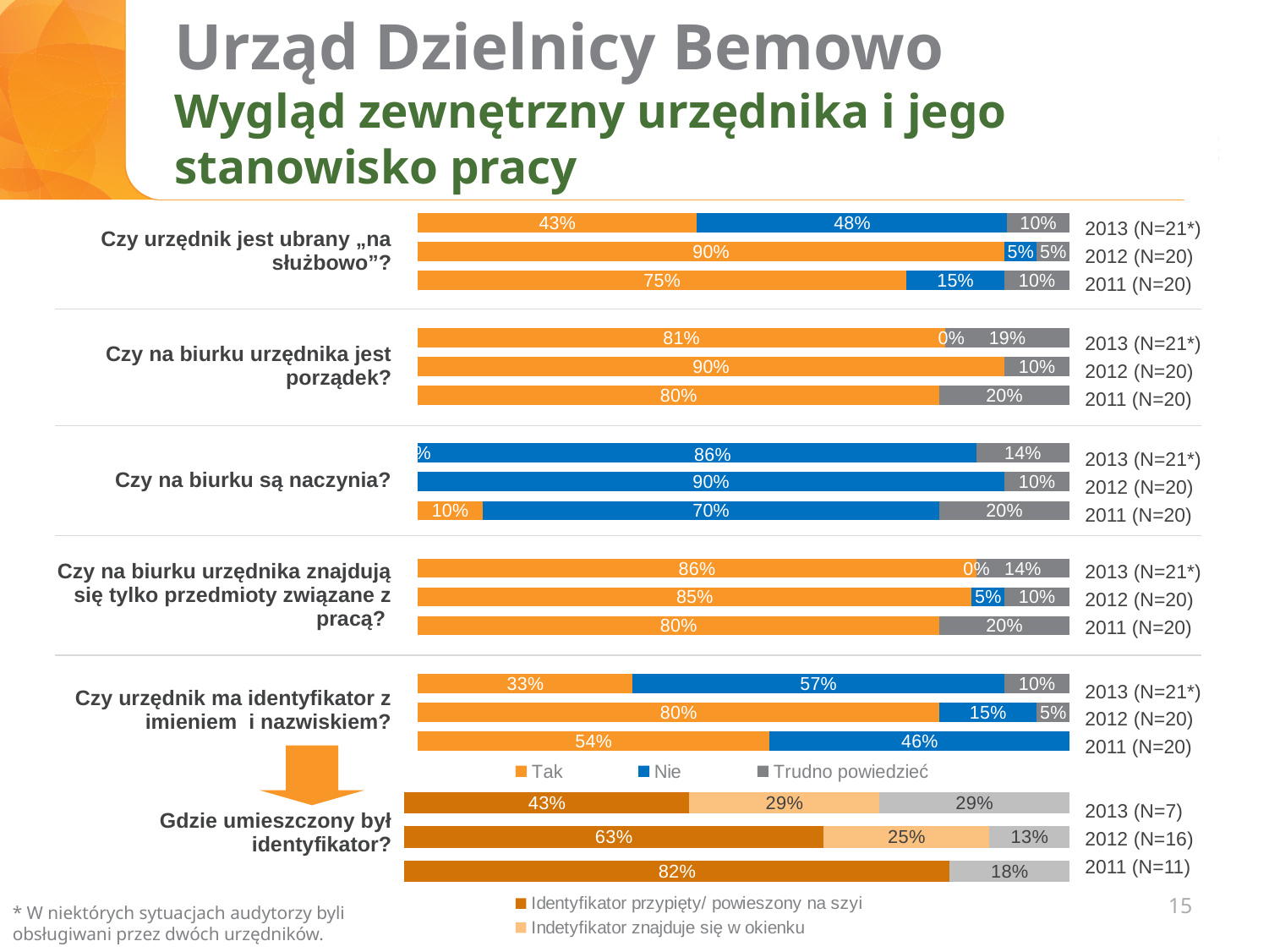
In the chart "Czy urzędnik ma identyfikator z imieniem i nazwiskiem?", what is the "Tak" value for 2012 (N=20)? 80% In the chart "Czy urzędnik ma identyfikator z imieniem i nazwiskiem?", which is larger in 2013 (N=21*): the "Tak" share or the "Nie" share? Nie In the chart "Gdzie umieszczony był identyfikator?", which year has the lowest share for "Identyfikator przypięty/ powieszony na szyi"? 2013 (N=7) In the chart "Czy urzędnik jest ubrany „na służbowo”?", what percentage answered "Tak" in 2013 (N=21*)? 43% In the chart "Czy na biurku urzędnika znajdują się tylko przedmioty związane z pracą?", what is the difference between the "Tak" values for 2013 (N=21*) and 2011 (N=20)? 6% What type of chart is used for "Czy urzędnik jest ubrany „na służbowo”?"? Stacked bar chart In the chart "Czy urzędnik jest ubrany „na służbowo”?", what percentage answered "Nie" in 2011 (N=20)? 15% How many series does the legend of the chart "Gdzie umieszczony był identyfikator?" list? 2 In the chart "Czy na biurku urzędnika jest porządek?", what is the "Trudno powiedzieć" value for 2013 (N=21*)? 19% In the chart "Czy na biurku urzędnika jest porządek?", which year has the highest "Tak" share? 2012 (N=20) In the chart "Gdzie umieszczony był identyfikator?", what percentage had the identifier pinned/hung on the neck ("Identyfikator przypięty/ powieszony na szyi") in 2011 (N=11)? 82% In the chart "Czy na biurku są naczynia?", what percentage answered "Nie" in 2011 (N=20)? 70%